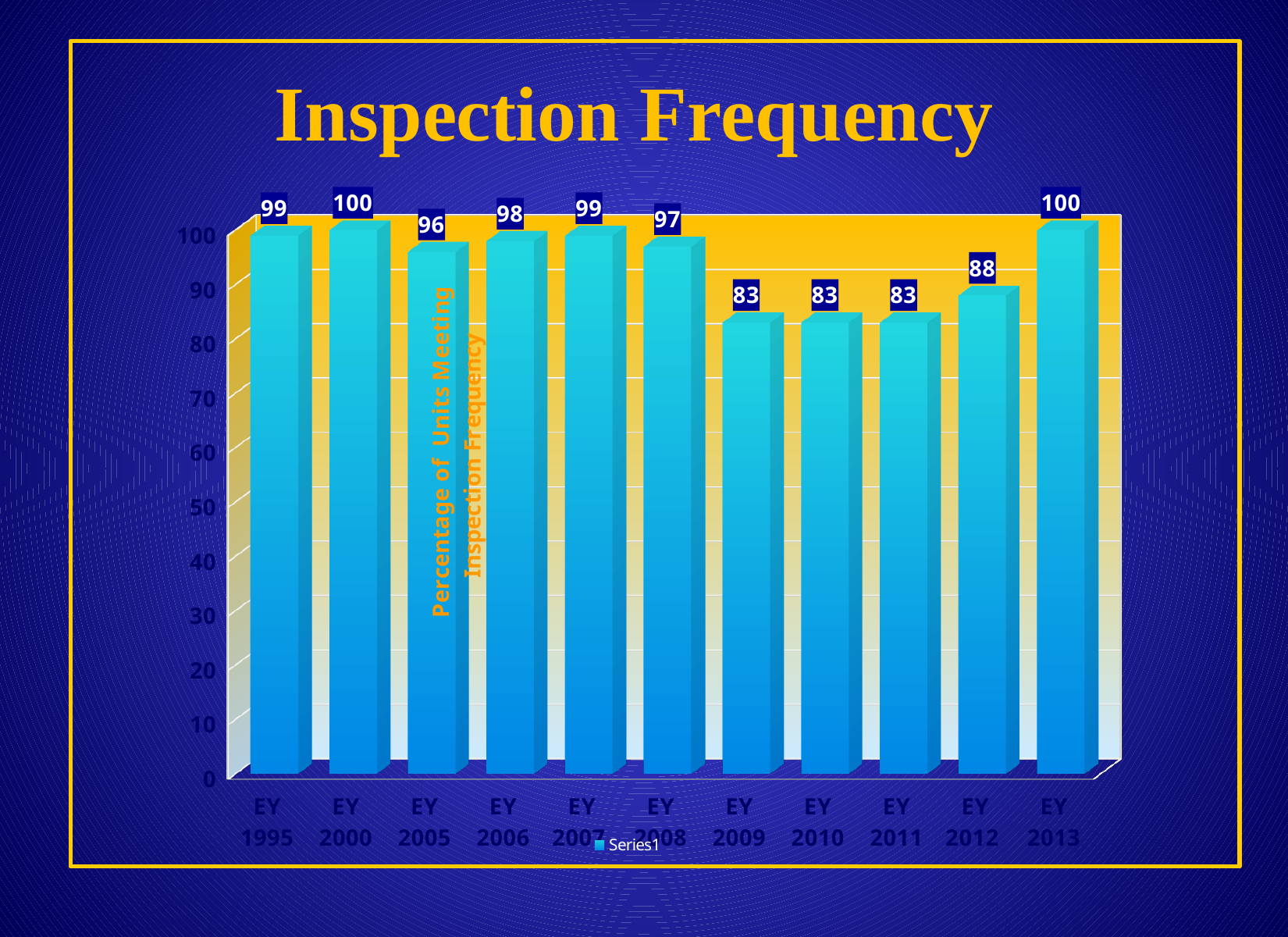
What is the difference between the values for EY 2000 and EY 2009? 17 How many series does the legend list? 1 What is the value for EY 2005? 96 What is the difference between the values for EY 2013 and EY 2012? 12 How many categories are shown on the x axis? 11 What is the value for EY 2008? 97 Which category has the lowest value? EY 2009, EY 2010 and EY 2011 (all 83) What is the value for EY 2012? 88 What kind of chart is shown? Bar chart What is the title of the chart? Inspection Frequency Which is larger, the value for EY 2006 or the value for EY 2012? EY 2006 Do the values rise or fall from EY 2008 to EY 2009? Fall